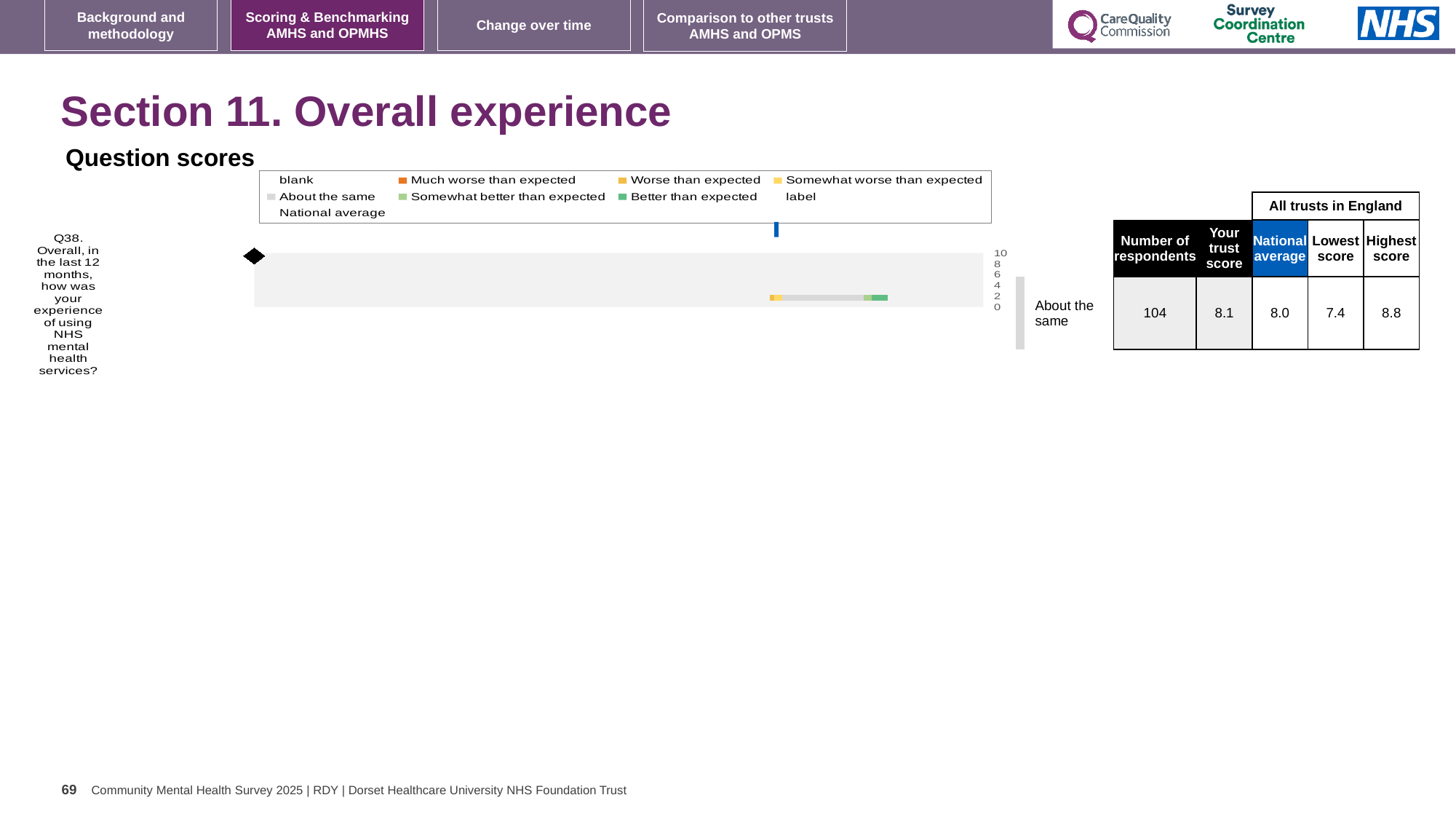
What is the lowest score among all trusts in England for Q38? 7.4 What is the highest score among all trusts in England for Q38? 8.8 What is the national average score for Q38? 8.0 Which question is plotted in the Question scores chart? Q38. Overall, in the last 12 months, how was your experience of using NHS mental health services? What is the difference between the highest and lowest scores among all trusts in England for Q38? 1.4 Which is larger for Q38, the trust's score or the national average? the trust's score What is the trust's score for Q38? 8.1 How many survey questions are plotted in the Question scores chart? 1 What benchmark category is shown next to the chart for Q38? About the same What is the number of respondents for Q38? 104 What kind of chart is shown under 'Question scores'? bar chart What is the highest tick value shown on the chart's score axis? 10